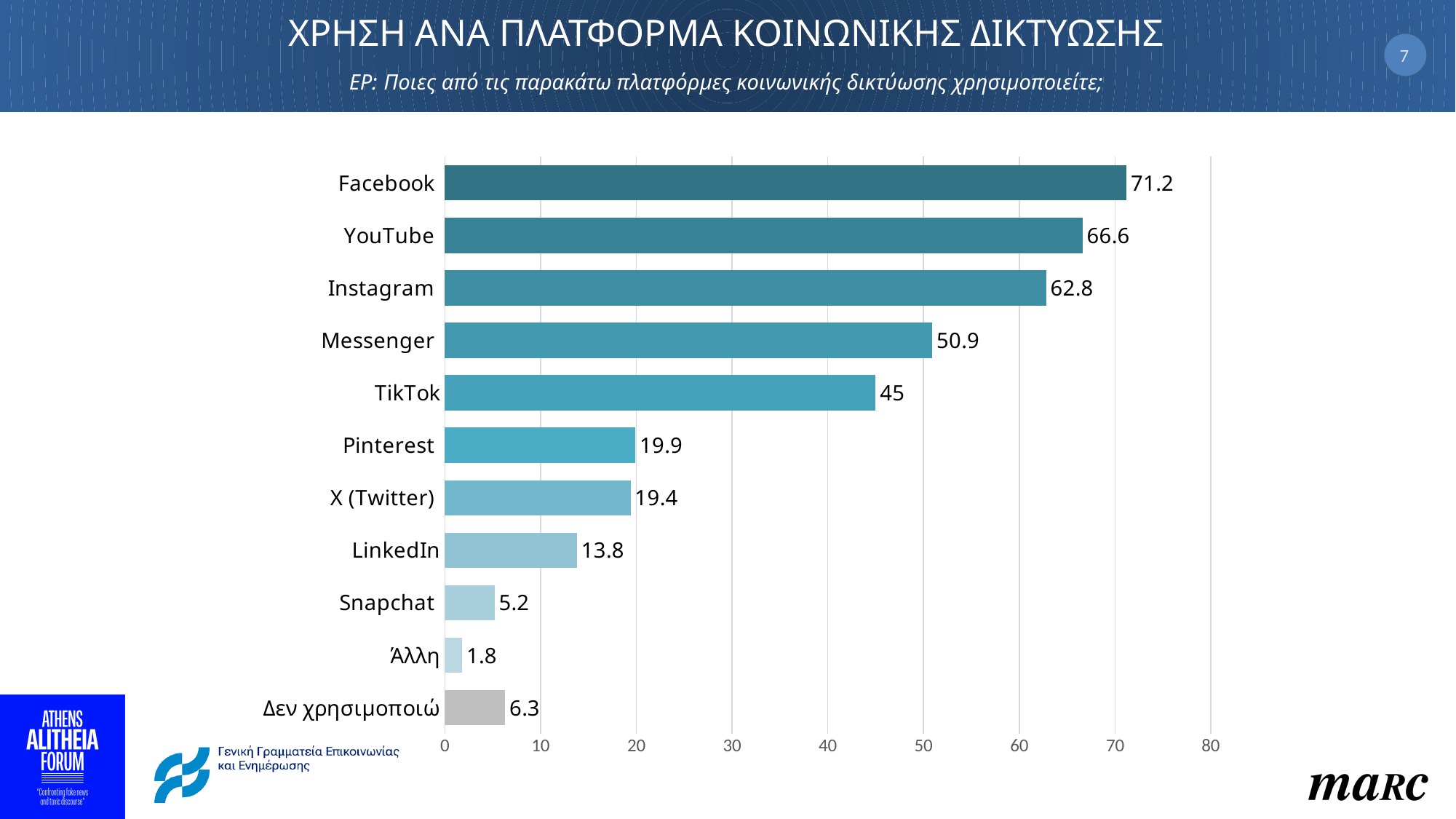
Which platform has the highest value? Facebook Which category has the lowest value? Άλλη Is the value for Pinterest greater or less than 10? greater What kind of chart is shown on the slide? Bar chart Which is larger, the value for Instagram or the value for Messenger? Instagram What is the difference between the values for Messenger and TikTok? 5.9 What is the value for Facebook? 71.2 How many categories are shown in the chart? 11 What is the value for TikTok? 45 What is the difference between the values for Facebook and YouTube? 4.6 What is the value for Δεν χρησιμοποιώ? 6.3 What is the value for LinkedIn? 13.8